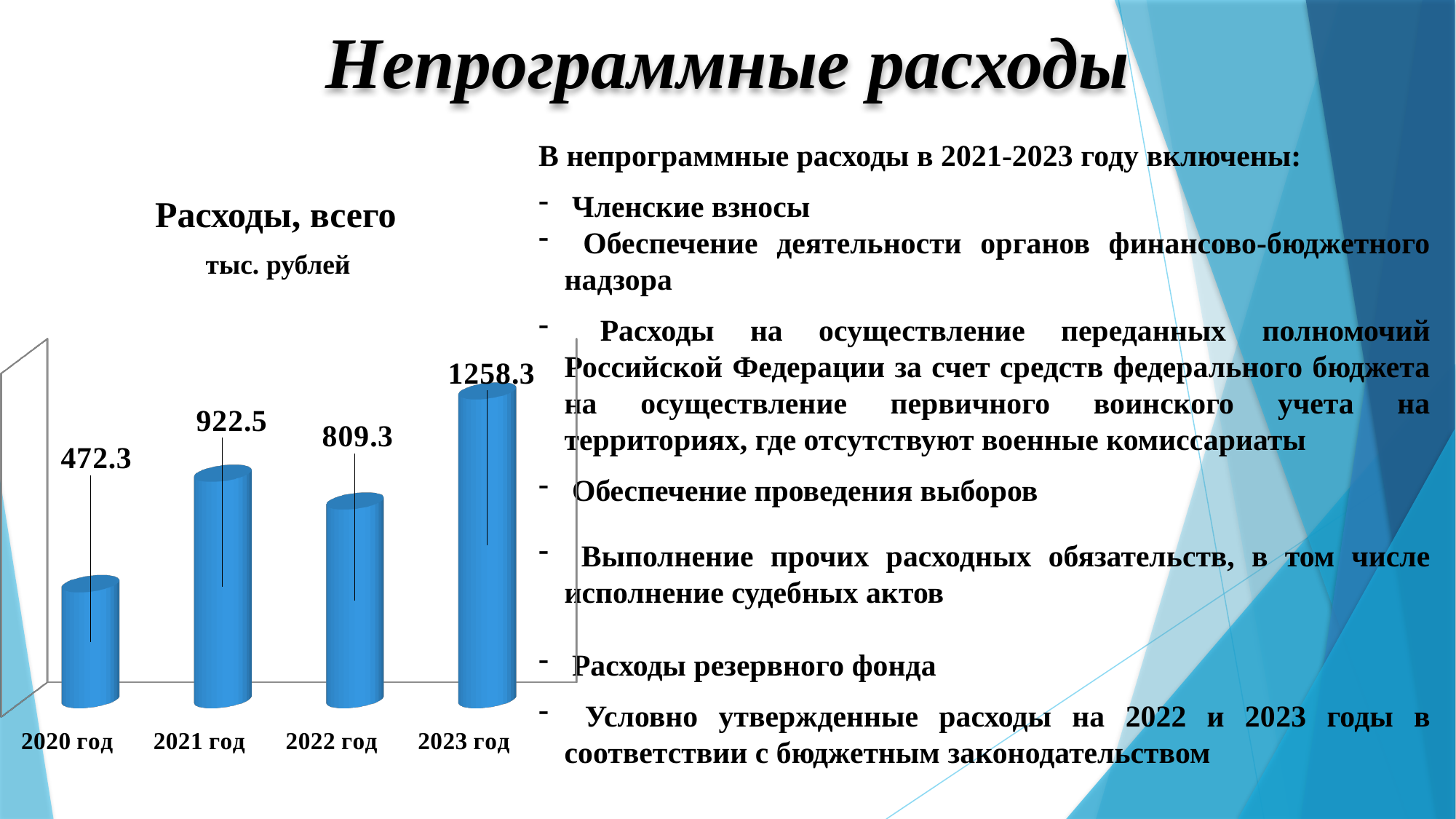
What is the value for 2023 год? 1258.3 What is the value for 2021 год? 922.5 Which year has the lowest value? 2020 год What is the title of the chart? Расходы, всего What is the value for 2022 год? 809.3 How many years are shown in the chart? 4 What is the difference between the values for 2021 год and 2022 год? 113.2 What is the value for 2020 год? 472.3 What kind of chart is shown on the slide? bar chart What is the difference between the values for 2023 год and 2020 год? 786 Which is larger, the value for 2021 год or 2022 год? 2021 год Which year has the highest value? 2023 год